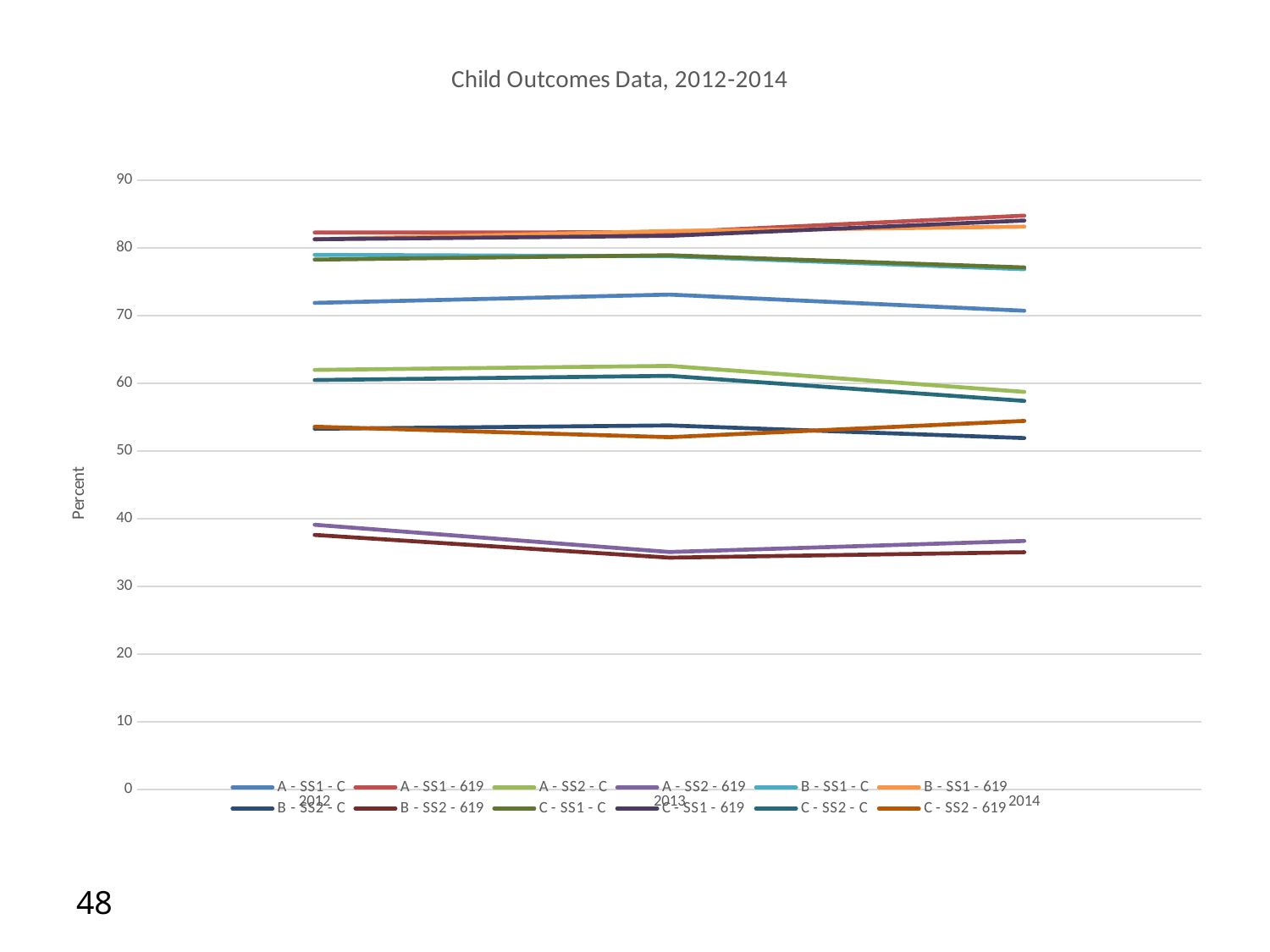
What is the label on the vertical axis? Percent How many years are plotted along the x axis? 3 Is the value for C - SS2 - C in 2014 greater or less than 60? less What is the title of the chart? Child Outcomes Data, 2012-2014 Is the value for A - SS1 - C in 2013 greater or less than 80? less Is the value for A - SS2 - 619 in 2013 greater or less than 40? less What kind of chart is shown on the slide? line chart Which is larger in 2012, the value for A - SS1 - C or the value for A - SS2 - C? A - SS1 - C Does the value for C - SS1 - 619 rise or fall from 2012 to 2014? rise How many series does the legend list? 12